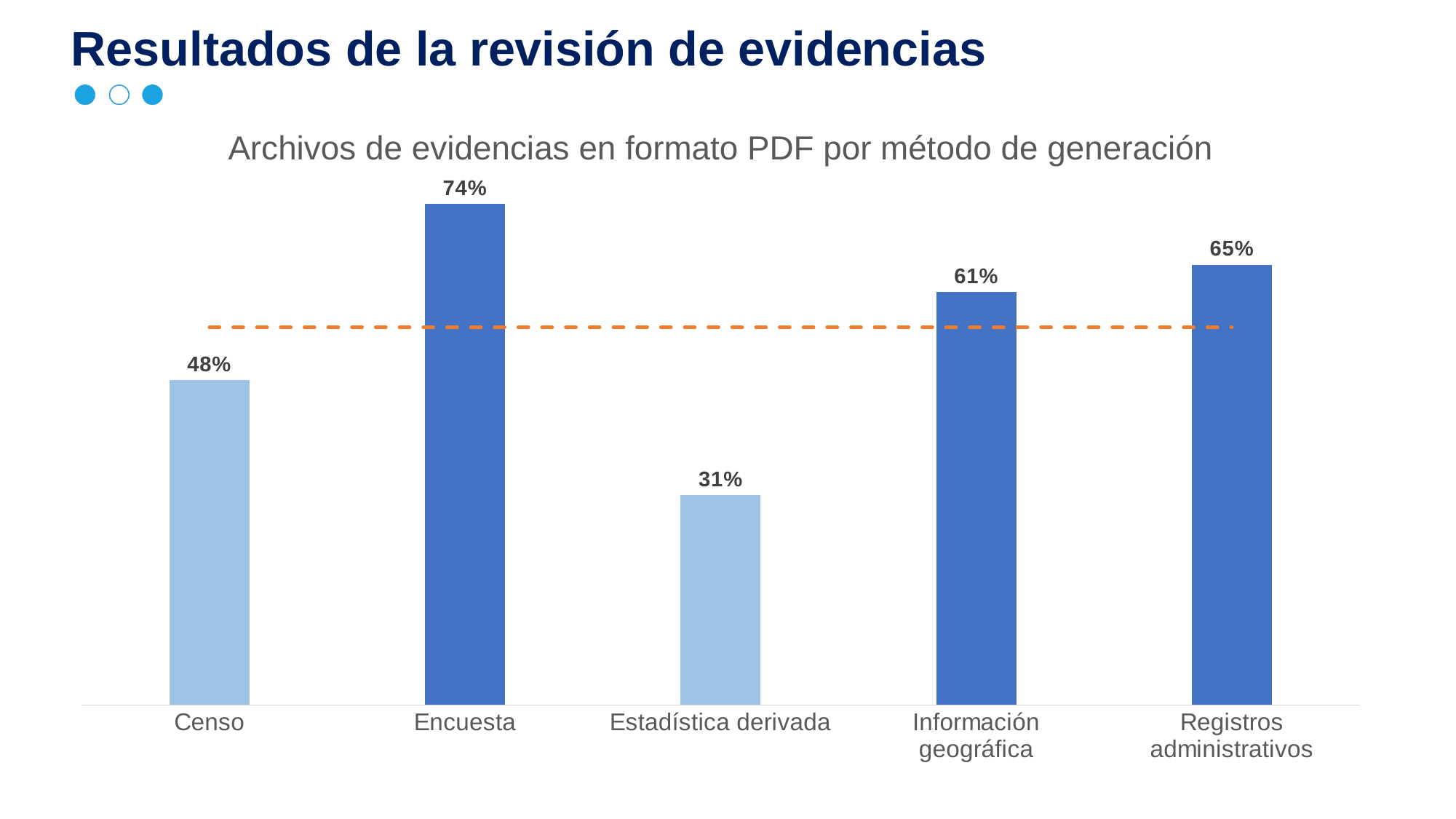
Which category has the lowest value? Estadística derivada How many categories are shown on the x axis? 5 What is the value for Estadística derivada? 31% What is the value for Registros administrativos? 65% What is the difference between the values for Encuesta and Censo? 26% What is the value for Encuesta? 74% What is the value for Censo? 48% What is the title of the chart? Archivos de evidencias en formato PDF por método de generación What kind of chart is shown on the slide? Bar chart What is the difference between the values for Registros administrativos and Información geográfica? 4% Which is larger, the value for Información geográfica or the value for Censo? Información geográfica Which category has the highest value? Encuesta